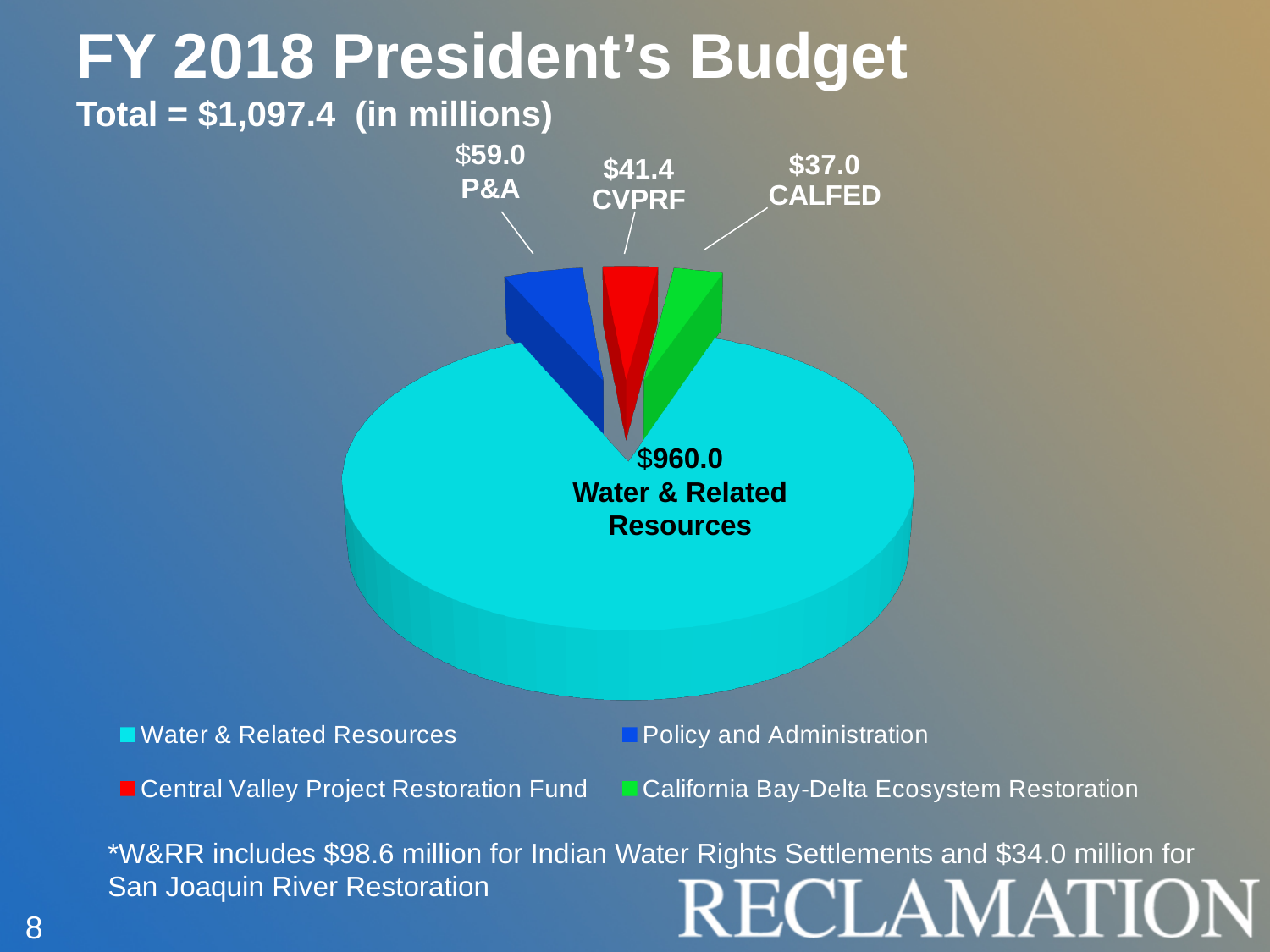
How many slices does the pie chart have? 4 What is the value for P&A (Policy and Administration)? $59.0 Which category has the smallest slice of the pie? CALFED What is the value for CALFED? $37.0 What is the difference between the P&A value and the CVPRF value? $17.6 Which category has the largest slice of the pie? Water & Related Resources What kind of chart is shown on the slide? Pie chart Which is larger, the CVPRF value or the CALFED value? CVPRF What colour is the Central Valley Project Restoration Fund slice? Red What is the value for CVPRF? $41.4 What is the value for Water & Related Resources? $960.0 What is the difference between the Water & Related Resources value and the P&A value? $901.0